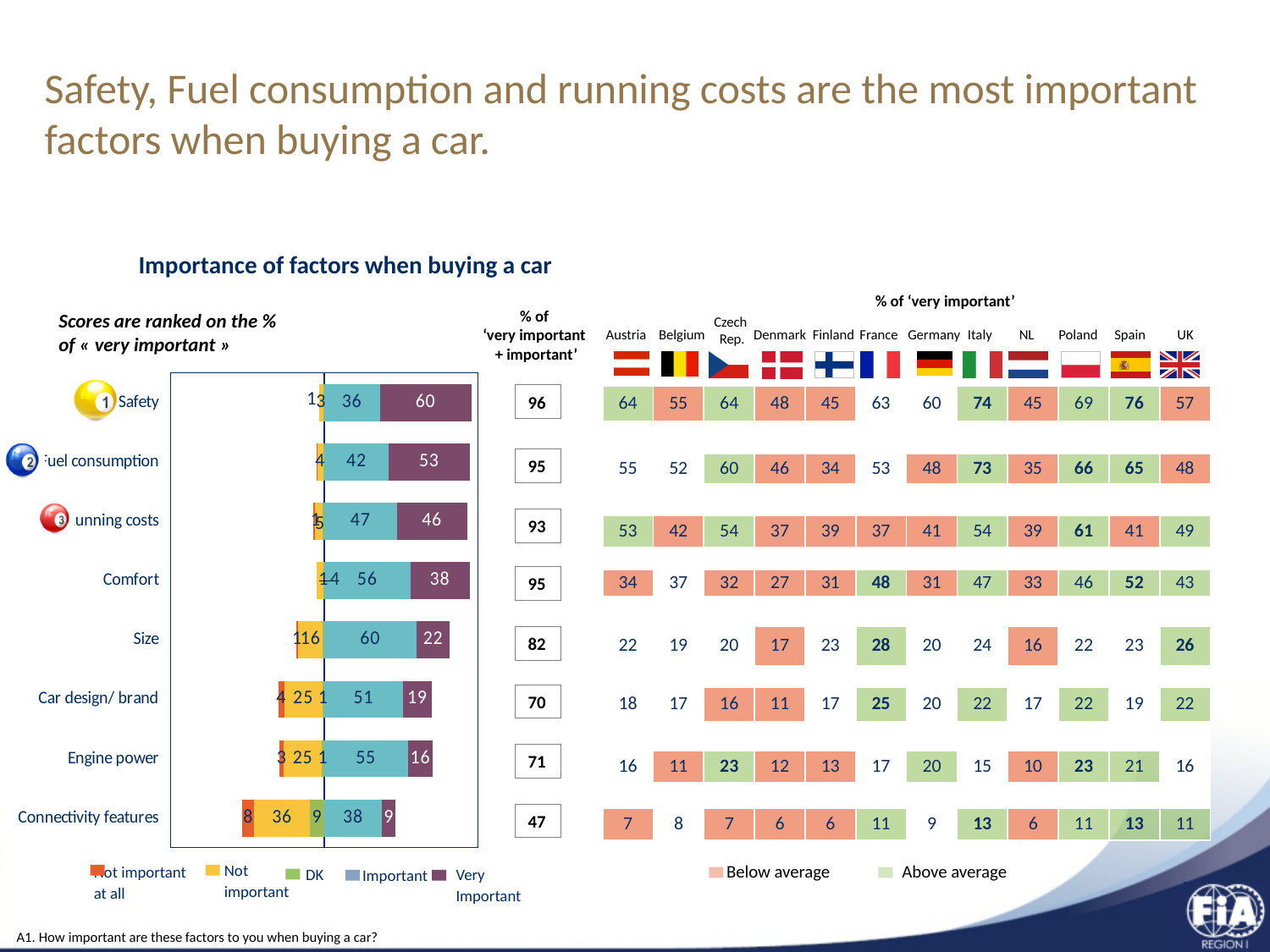
In the 'Importance of factors when buying a car' chart, for Comfort, which is larger: the 'Important' value or the 'Very Important' value? Important In the 'Importance of factors when buying a car' chart, what is the difference between the 'Very Important' values for Safety and Fuel consumption? 7 In the 'Importance of factors when buying a car' chart, what is the 'Not important' value for Connectivity features? 36 In the 'Importance of factors when buying a car' chart, which factor has the lowest 'Very Important' value? Connectivity features How many factors are listed in the 'Importance of factors when buying a car' chart? 8 In the 'Importance of factors when buying a car' chart, what is the 'Very Important' value for Safety? 60 In the 'Importance of factors when buying a car' chart, what is the 'Important' value for Comfort? 56 How many series does the legend of the 'Importance of factors when buying a car' chart list? 5 In the 'Importance of factors when buying a car' chart, which factor has the highest 'Very Important' value? Safety In the 'Importance of factors when buying a car' chart, what is the '% of very important + important' shown for Size? 82 What type of chart is 'Importance of factors when buying a car'? bar chart In the 'Importance of factors when buying a car' chart, what is the total of the stacked bar for Connectivity features? 100